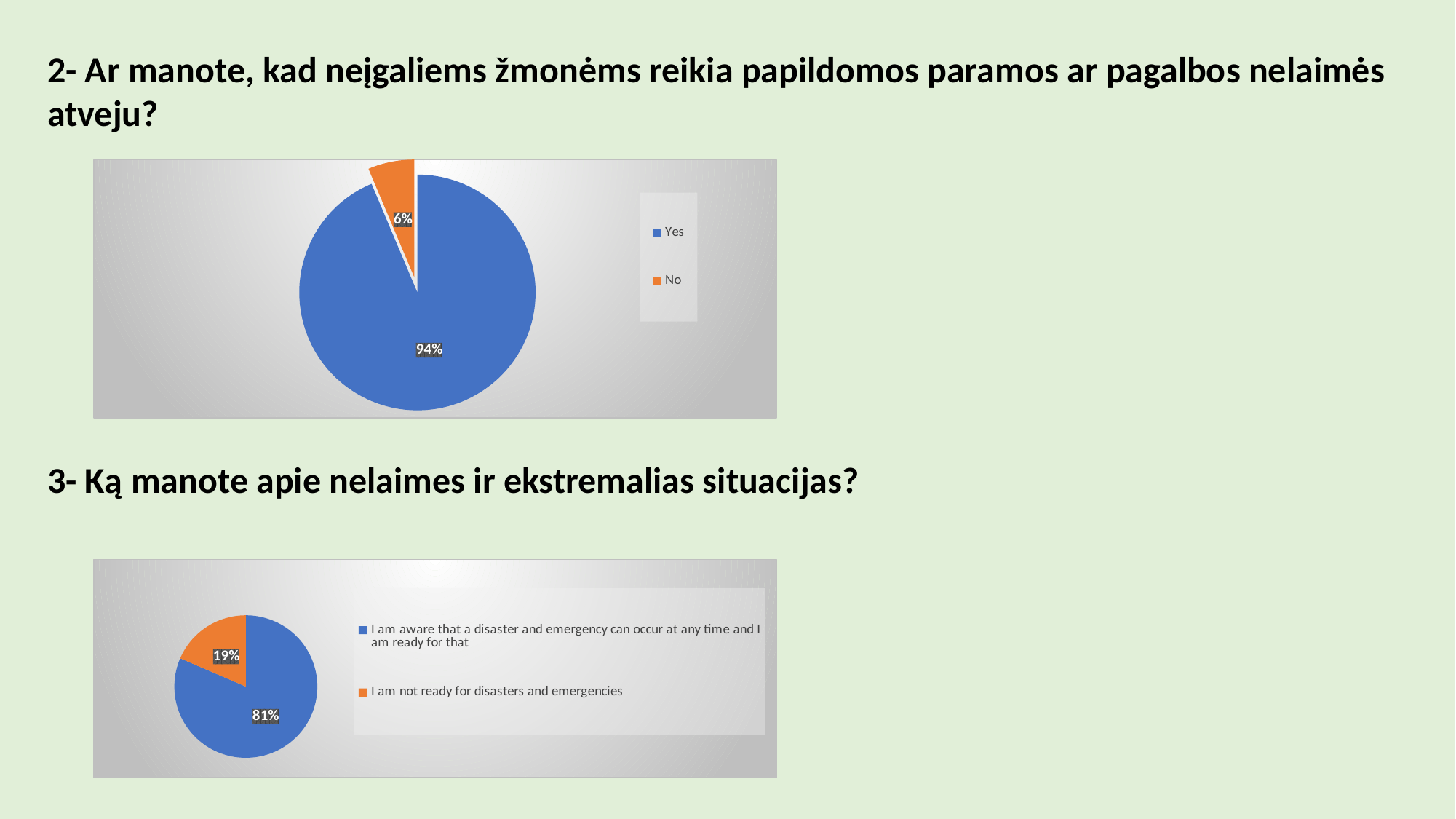
In the bottom pie chart, what is the difference in percentage points between the two slices? 62 In the top pie chart, what percentage of respondents answered Yes? 94% In the top pie chart, which category has the largest share? Yes In the bottom pie chart, how many slices are there? 2 In the top pie chart, what percentage of respondents answered No? 6% In the bottom pie chart, what percentage of respondents said they are aware that a disaster and emergency can occur at any time and are ready for that? 81% In the bottom pie chart, which category has the smallest share? I am not ready for disasters and emergencies In the top pie chart, which colour represents the No category? Orange What kind of chart is the top chart? Pie chart In the top pie chart, how many categories does the legend list? 2 In the top pie chart, what is the difference in percentage points between Yes and No? 88 In the bottom pie chart, what percentage of respondents said they are not ready for disasters and emergencies? 19%